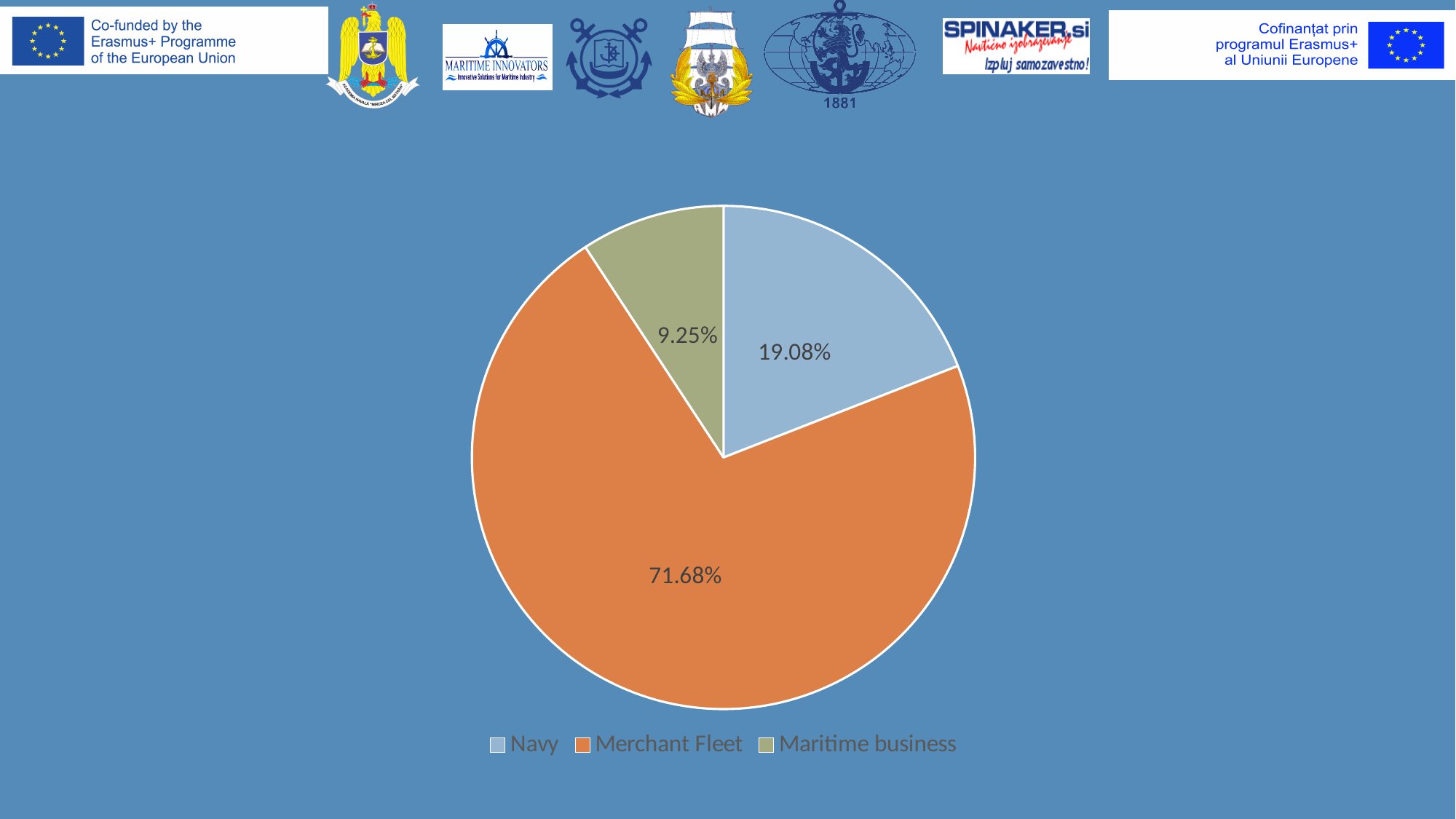
Which category has the smallest slice of the pie? Maritime business What is the difference between the Merchant Fleet share and the Navy share? 52.60% What share of the pie does Merchant Fleet have? 71.68% Which is larger, the Navy slice or the Maritime business slice? Navy How many categories does the pie chart show? 3 Which category is listed first in the legend? Navy What is the difference between the Navy share and the Maritime business share? 9.83% Which category has the largest slice of the pie? Merchant Fleet What share of the pie does Navy have? 19.08% What share of the pie does Maritime business have? 9.25% What colour is the Merchant Fleet slice in the pie chart? orange What kind of chart is shown on the slide? pie chart